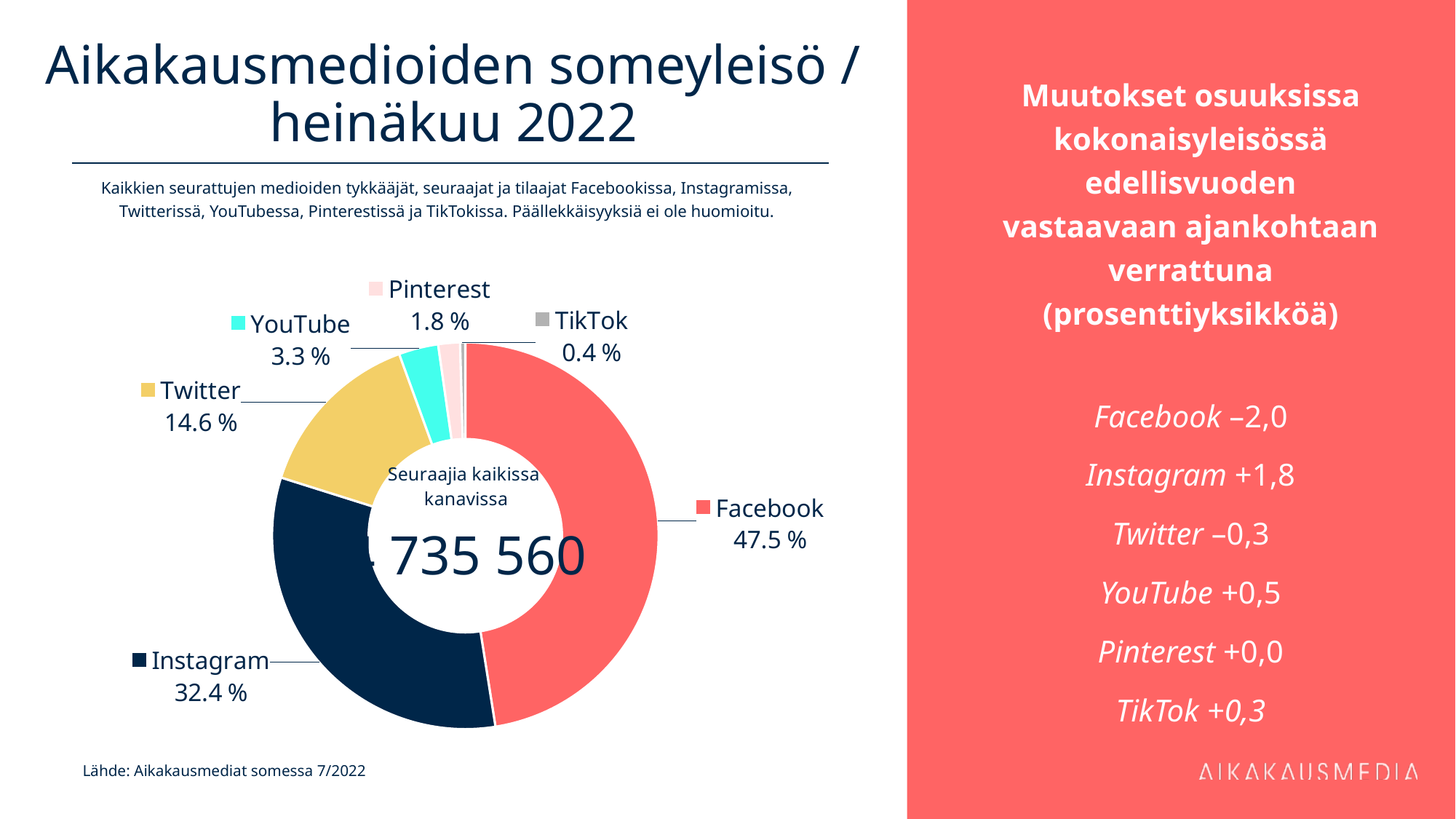
What share does Instagram have in the chart? 32.4 % What is the share shown for Pinterest? 1.8 % How many percentage points larger is Facebook's share than Instagram's? 15.1 What kind of chart is shown on the slide? Pie chart (donut) Which has a larger share, Twitter or YouTube? Twitter What is the share shown for YouTube? 3.3 % What is the share shown for TikTok? 0.4 % Which channel has the largest share in the chart? Facebook What share of the social media audience does Facebook have? 47.5 % How many channels are shown in the chart? 6 What is the share shown for Twitter? 14.6 % Which channel has the smallest share in the chart? TikTok